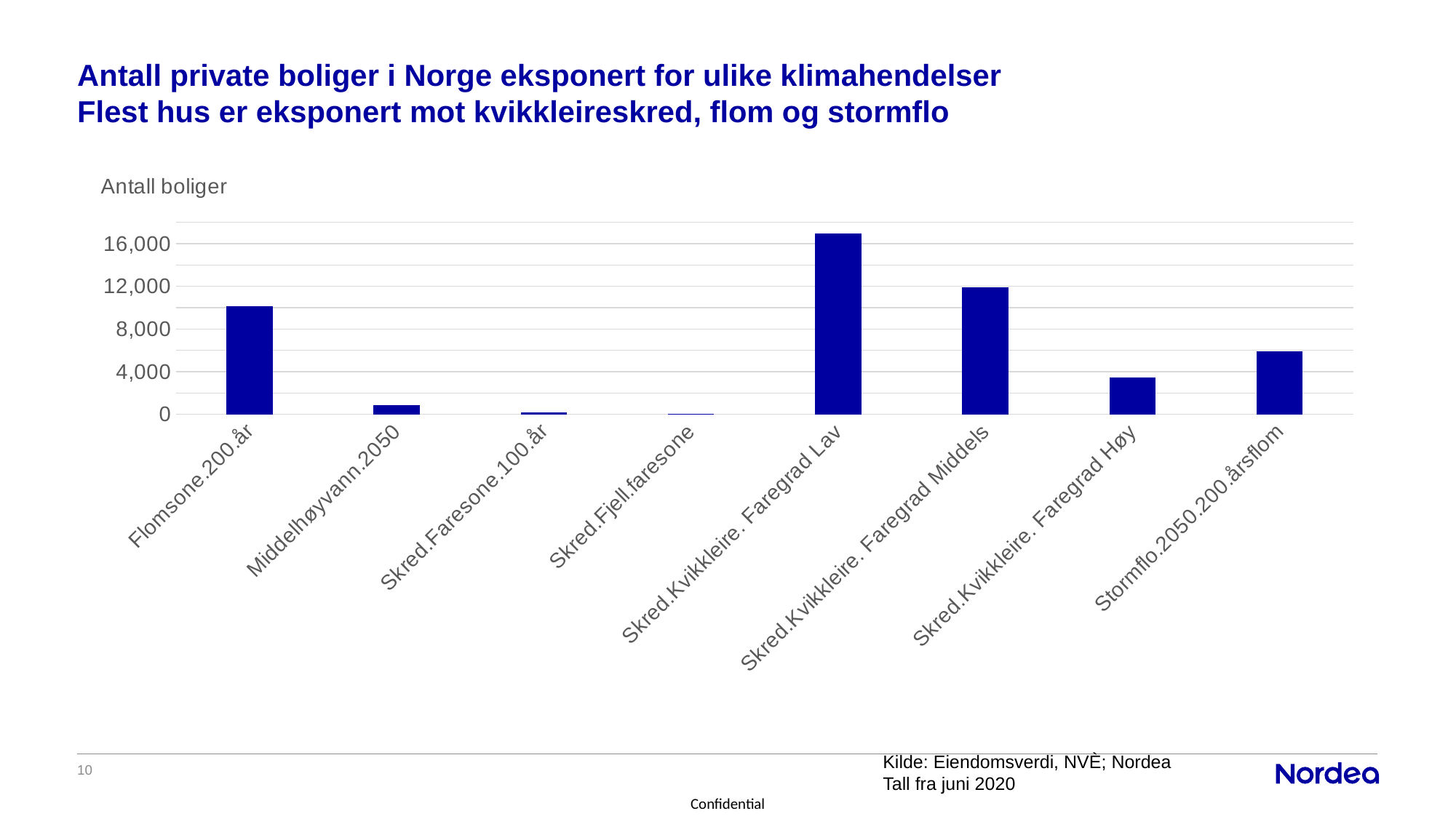
What is the highest value shown on the y axis of the chart? 16,000 How many categories are shown on the x axis of the chart? 8 What kind of chart is shown on the slide? bar chart Is the value for Skred.Kvikkleire. Faregrad Høy greater or less than 4,000? less Which is larger, the value for Middelhøyvann.2050 or the value for Skred.Kvikkleire. Faregrad Høy? Skred.Kvikkleire. Faregrad Høy Is the value for Stormflo.2050.200.årsflom greater or less than 8,000? less Is the value for Skred.Kvikkleire. Faregrad Lav greater or less than 16,000? greater Which is larger, the value for Flomsone.200.år or the value for Stormflo.2050.200.årsflom? Flomsone.200.år What is the label shown above the y axis of the chart? Antall boliger Which category has the highest number of boliger? Skred.Kvikkleire. Faregrad Lav